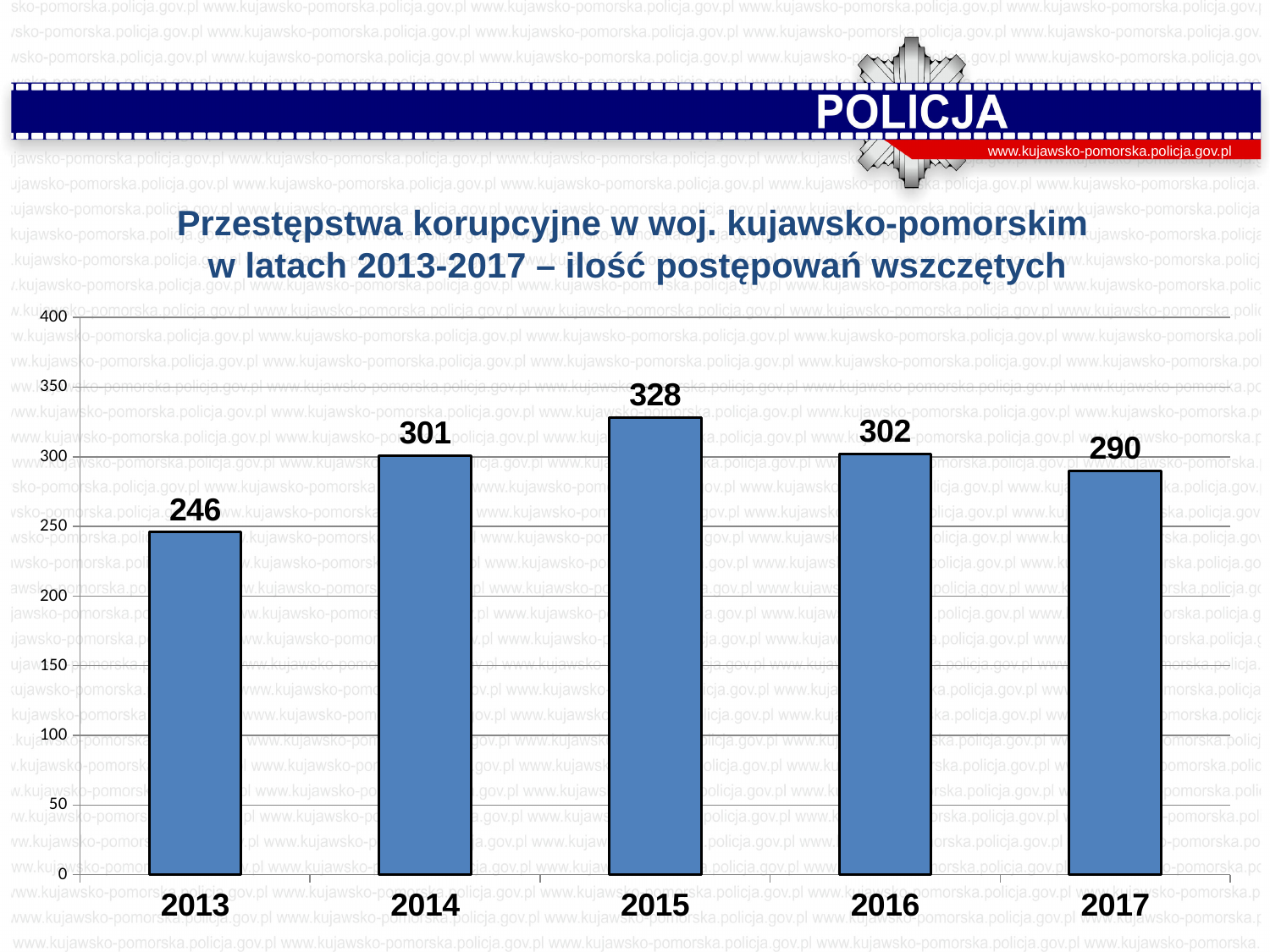
What is the difference between the values for 2016 and 2017? 12 Which year has the lowest value? 2013 How many years are shown on the x axis? 5 Is the value for 2013 greater or less than 250? less What is the title of the chart? Przestępstwa korupcyjne w woj. kujawsko-pomorskim w latach 2013-2017 – ilość postępowań wszczętych Which year has the highest value? 2015 What is the value for 2017? 290 What kind of chart is shown on the slide? bar chart What is the value for 2015? 328 Which is larger, the value for 2014 or the value for 2017? 2014 What is the difference between the values for 2015 and 2013? 82 What is the value for 2013? 246